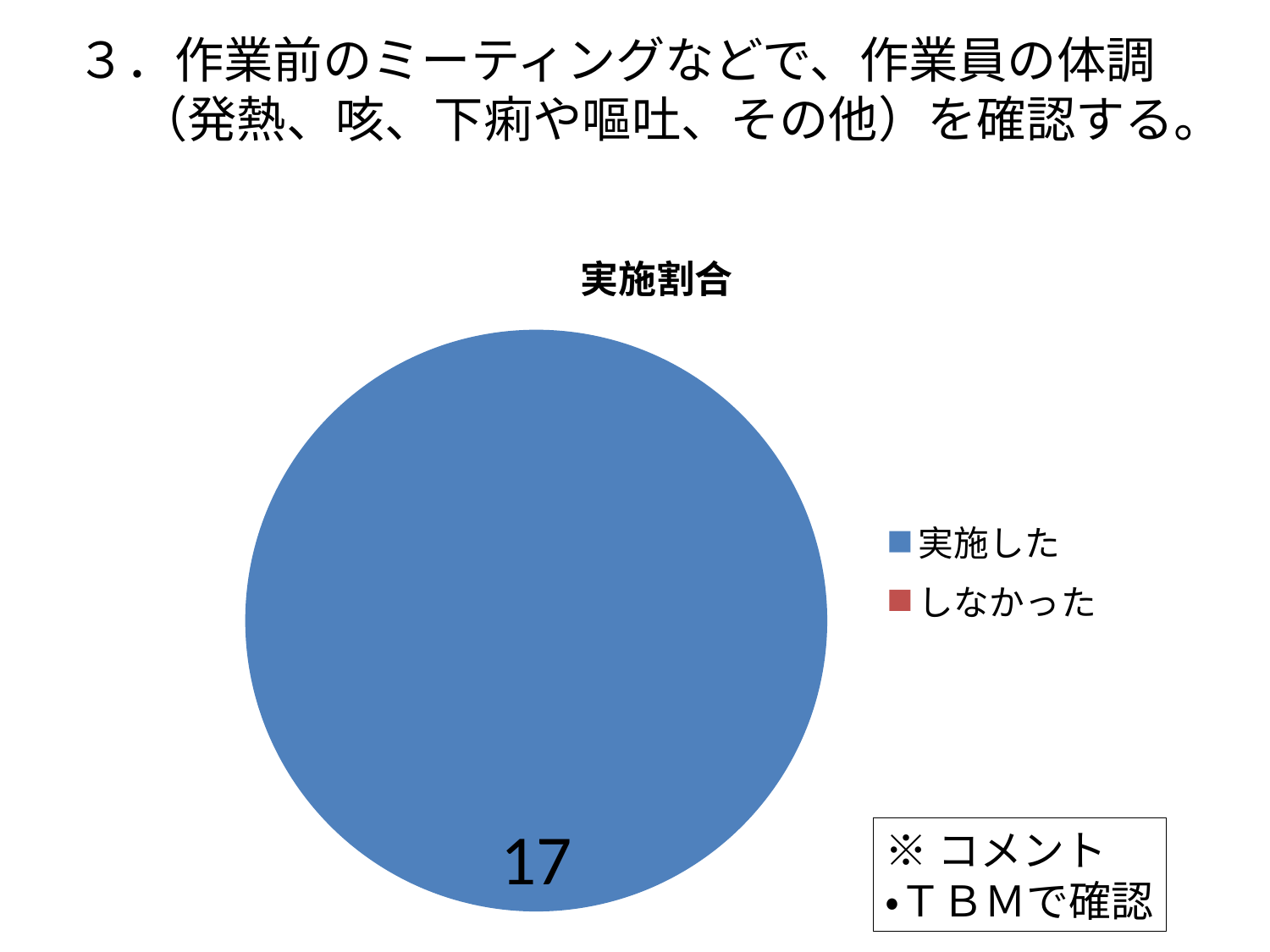
What kind of chart is shown on the slide? pie chart Is the value for 実施した greater or less than 10? greater What is the title of the chart? 実施割合 What value is printed on the pie for 実施した? 17 What colour is the slice for 実施した? blue Which category has the smaller share of the pie, 実施した or しなかった? しなかった How many entries does the chart legend list? 2 Which category occupies the largest share of the pie? 実施した How many slices are visibly drawn in the pie? 1